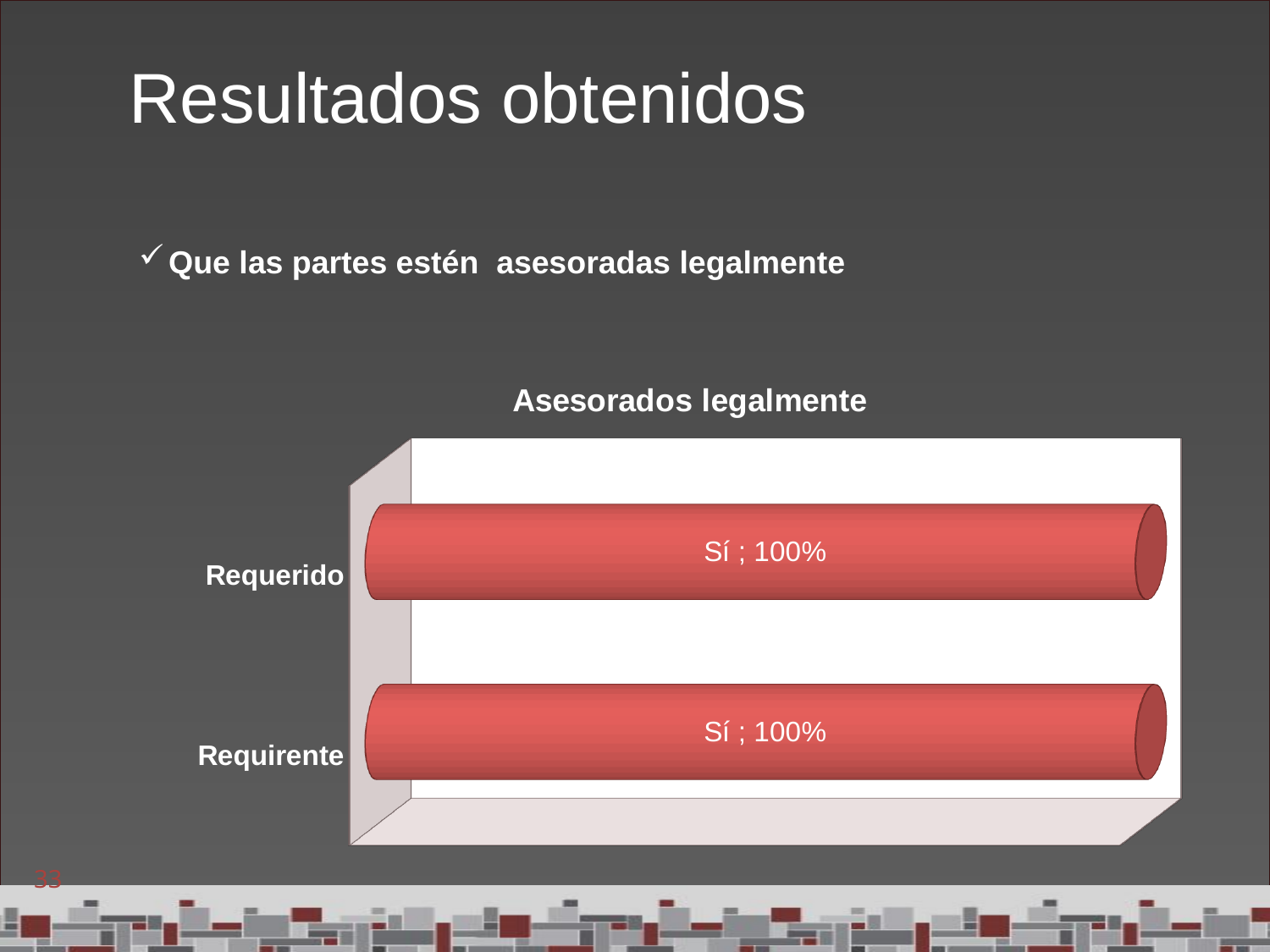
What response label is shown on the bars in the chart? Sí What is the value shown for Requerido? 100% What is the value shown for Requirente? 100% What is the title of the chart? Asesorados legalmente How many categories does the chart show? 2 What is the difference between the values for Requerido and Requirente? 0% What kind of chart is shown on the slide? bar chart Is the value for Requerido greater than or equal to 100%? equal